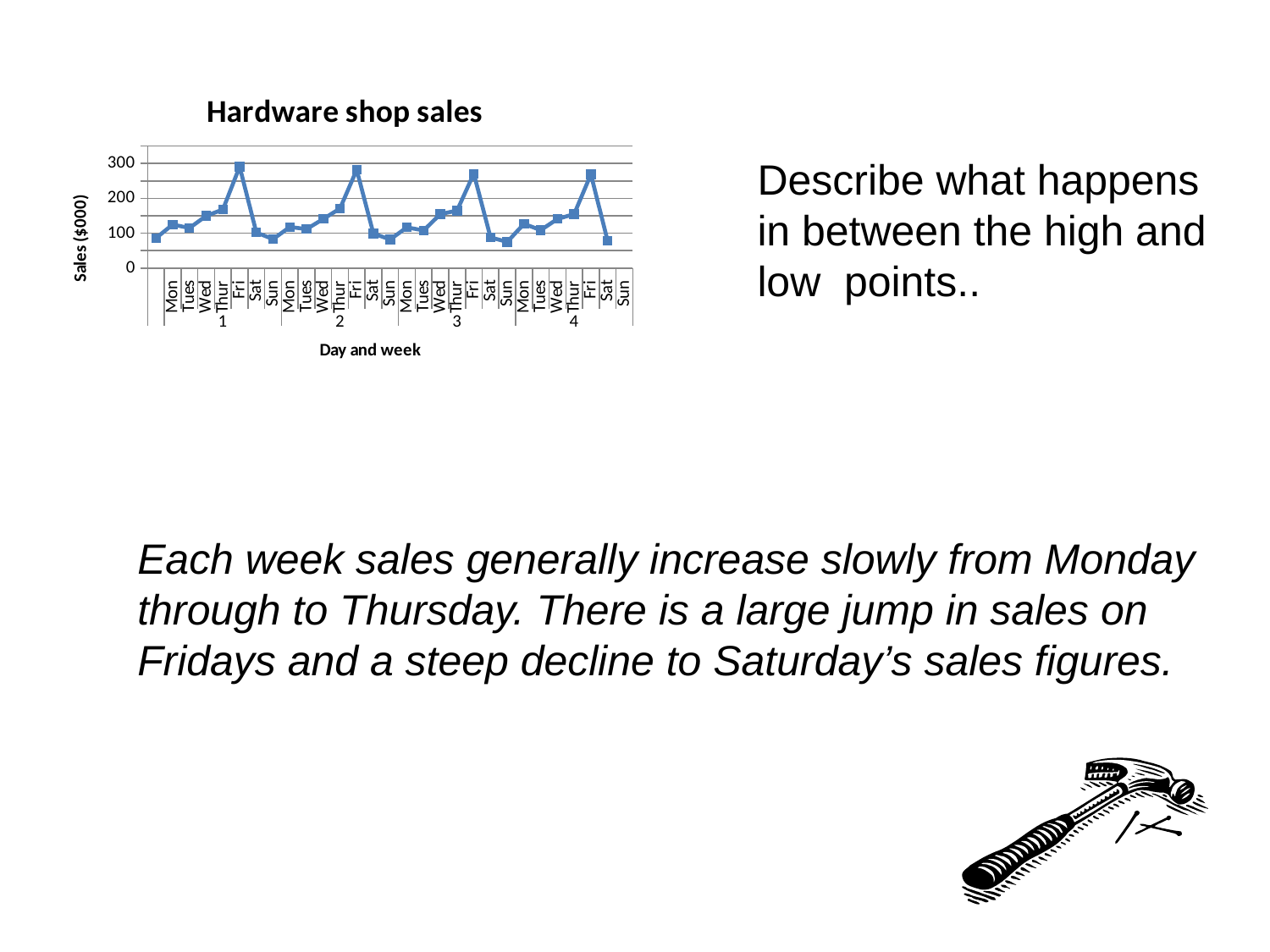
What is the title of the chart? Hardware shop sales Is the value for Fri in week 3 greater or less than 200? greater Which day of the week has the highest sales in each week? Fri Is the value for Mon in week 1 greater or less than 100? greater What is the label on the vertical axis of the chart? Sales ($000) Is the value for Fri in week 1 greater or less than 200? greater What kind of chart is shown on the slide? line chart How many data points are plotted on the chart? 28 Do sales rise or fall from Mon to Thur in week 1? rise Which is larger, the value for Fri in week 2 or the value for Sat in week 2? Fri in week 2 How many weeks are shown along the x axis of the chart? 4